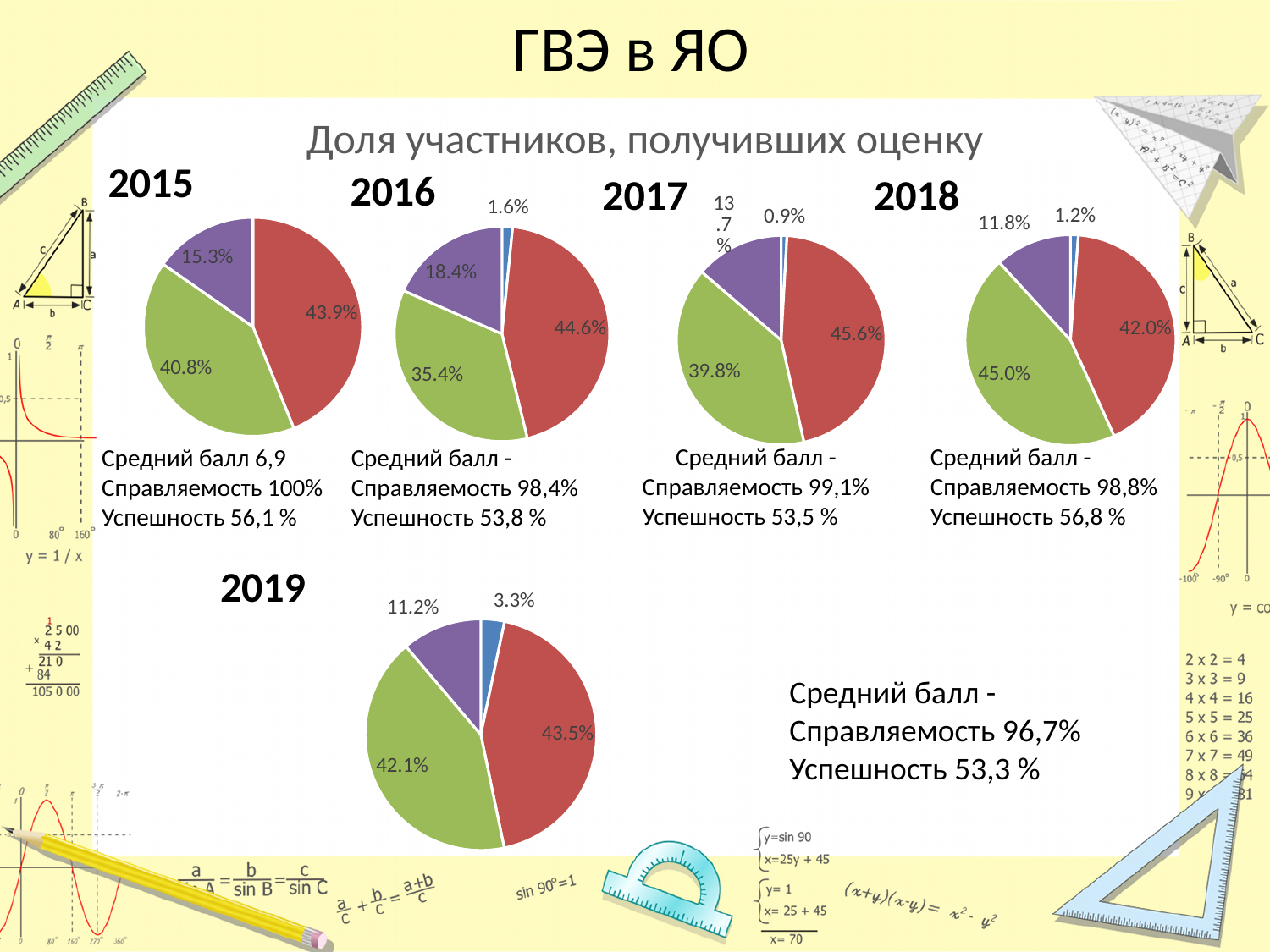
In the 2017 pie chart, which slice is the smallest? blue (0.9%) In the 2019 pie chart, which is larger, the red slice or the purple slice? red (43.5%) In the 2016 pie chart, what is the difference between the red slice and the green slice? 9.2% In the 2015 pie chart, what percentage does the red slice show? 43.9% How many slices does the 2015 pie chart have? 3 In the 2019 pie chart, what percentage does the blue slice show? 3.3% How many slices does the 2019 pie chart have? 4 What kind of chart is used for each year on this slide? pie chart In the 2016 pie chart, what percentage does the blue slice show? 1.6% In the 2018 pie chart, which slice is the largest? green (45.0%) In the 2017 pie chart, what percentage does the green slice show? 39.8% In the 2018 pie chart, what percentage does the purple slice show? 11.8%